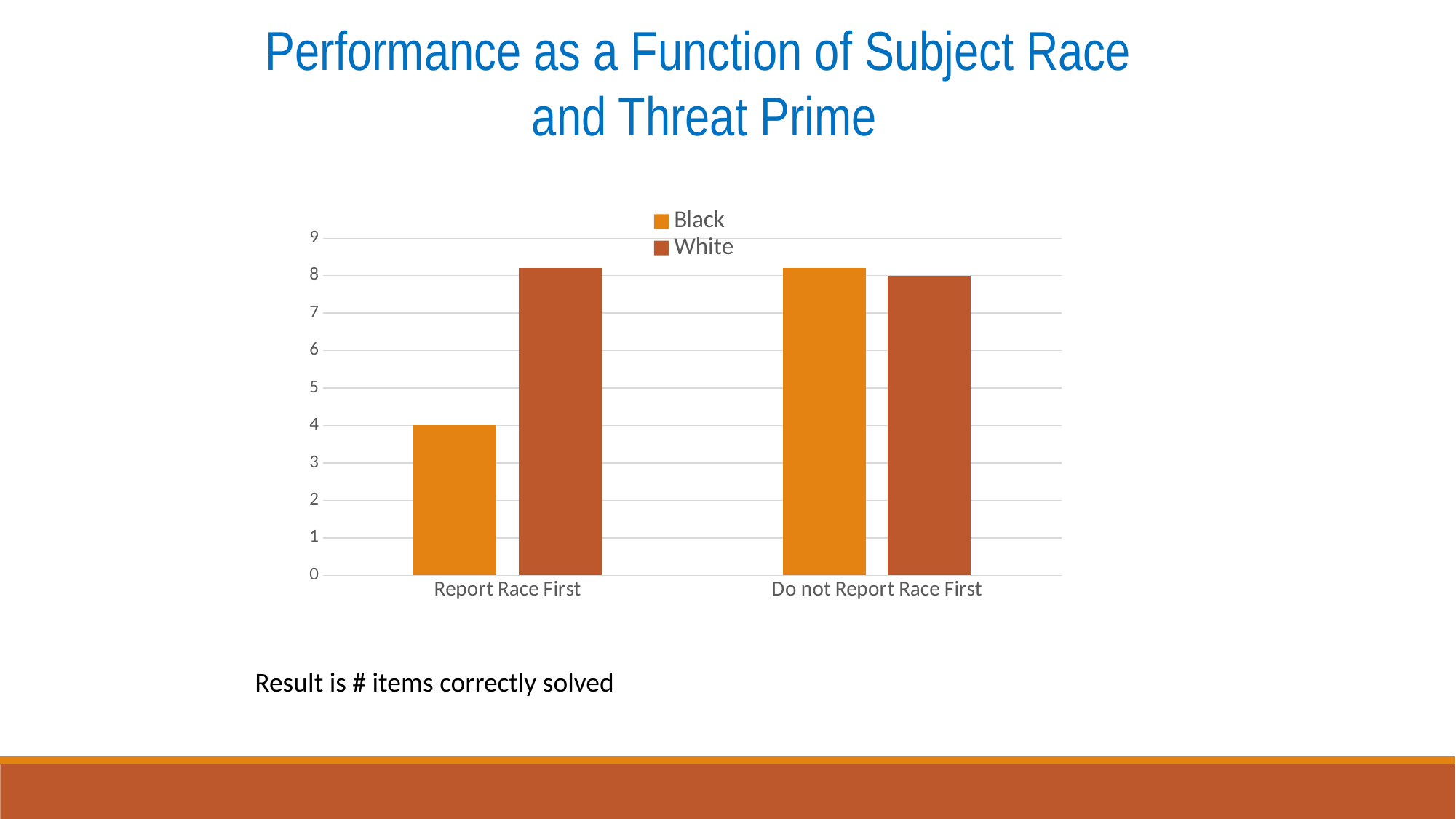
In the Report Race First category, which series has the larger value, Black or White? White What is the value for White in the Do not Report Race First category? 8 Is the value for Black in the Report Race First category greater or less than 5? less Which bar on the chart has the lowest value? Black, Report Race First How many categories are shown on the x axis? 2 Is the value for White in the Report Race First category greater or less than 7? greater Is the value for Black in the Do not Report Race First category greater or less than 6? greater What is the value for Black in the Report Race First category? 4 What kind of chart is shown on the slide? bar chart Which series is shown in the darker brown colour? White What is the title of the slide? Performance as a Function of Subject Race and Threat Prime How many series does the legend list? 2